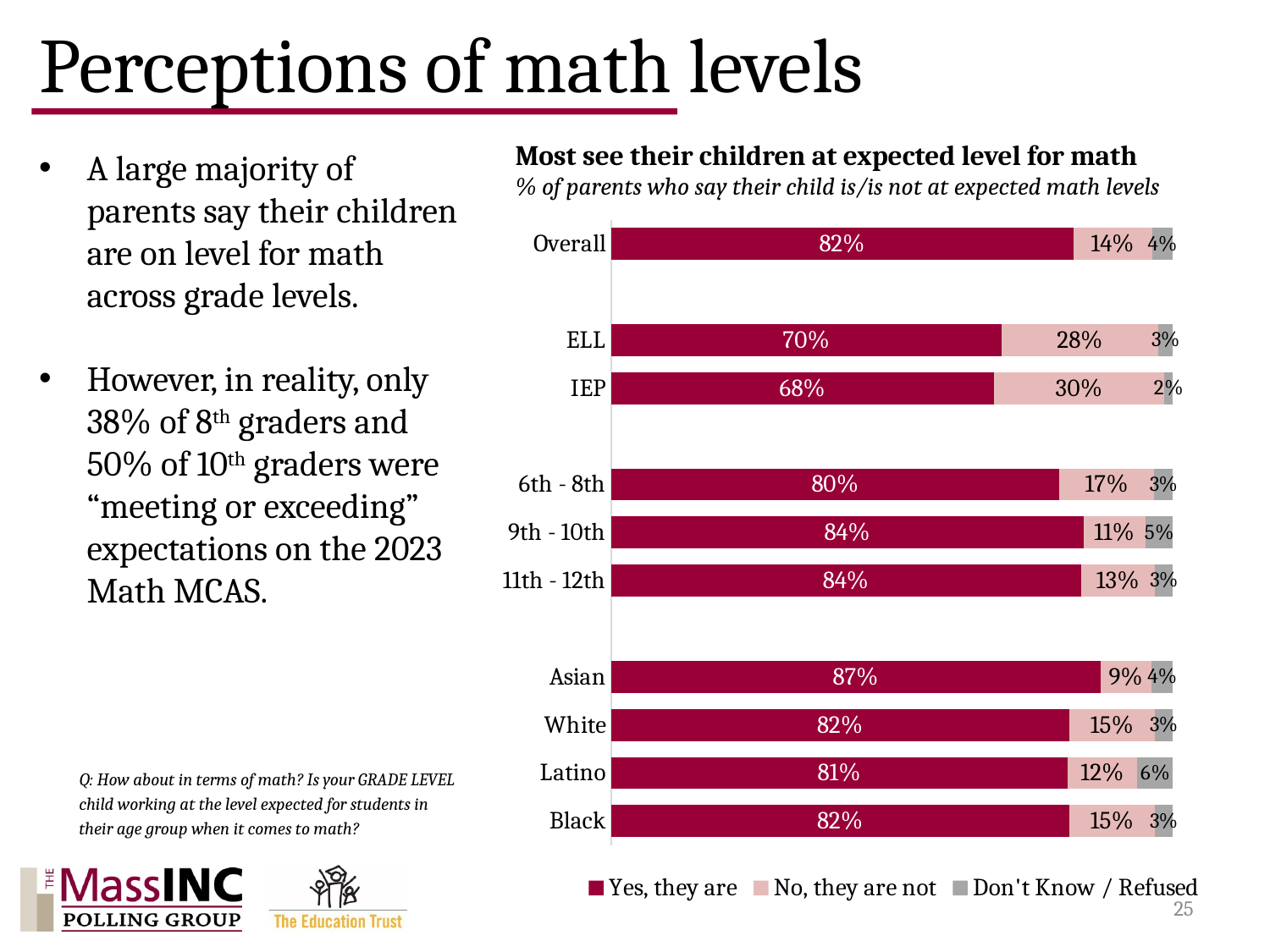
Which group has the lowest percentage of parents saying "Yes, they are" at expected math level? IEP What is the title of the chart? Most see their children at expected level for math What type of chart is shown on the slide? Stacked bar chart How many groups (categories) are shown on the chart? 10 Which group has a larger "Yes, they are" percentage, 6th - 8th or 9th - 10th? 9th - 10th What percentage of IEP parents say their child is not at the expected math level? 30% What percentage of parents overall say their child is at the expected math level ("Yes, they are")? 82% What is the "Don't Know / Refused" percentage for Latino parents? 6% Which group has the highest percentage of parents saying "Yes, they are" at expected math level? Asian How many series does the legend list? 3 Which group has the highest percentage of parents saying "No, they are not"? IEP What is the difference in percentage points between the "Yes, they are" values for ELL and IEP parents? 2 percentage points